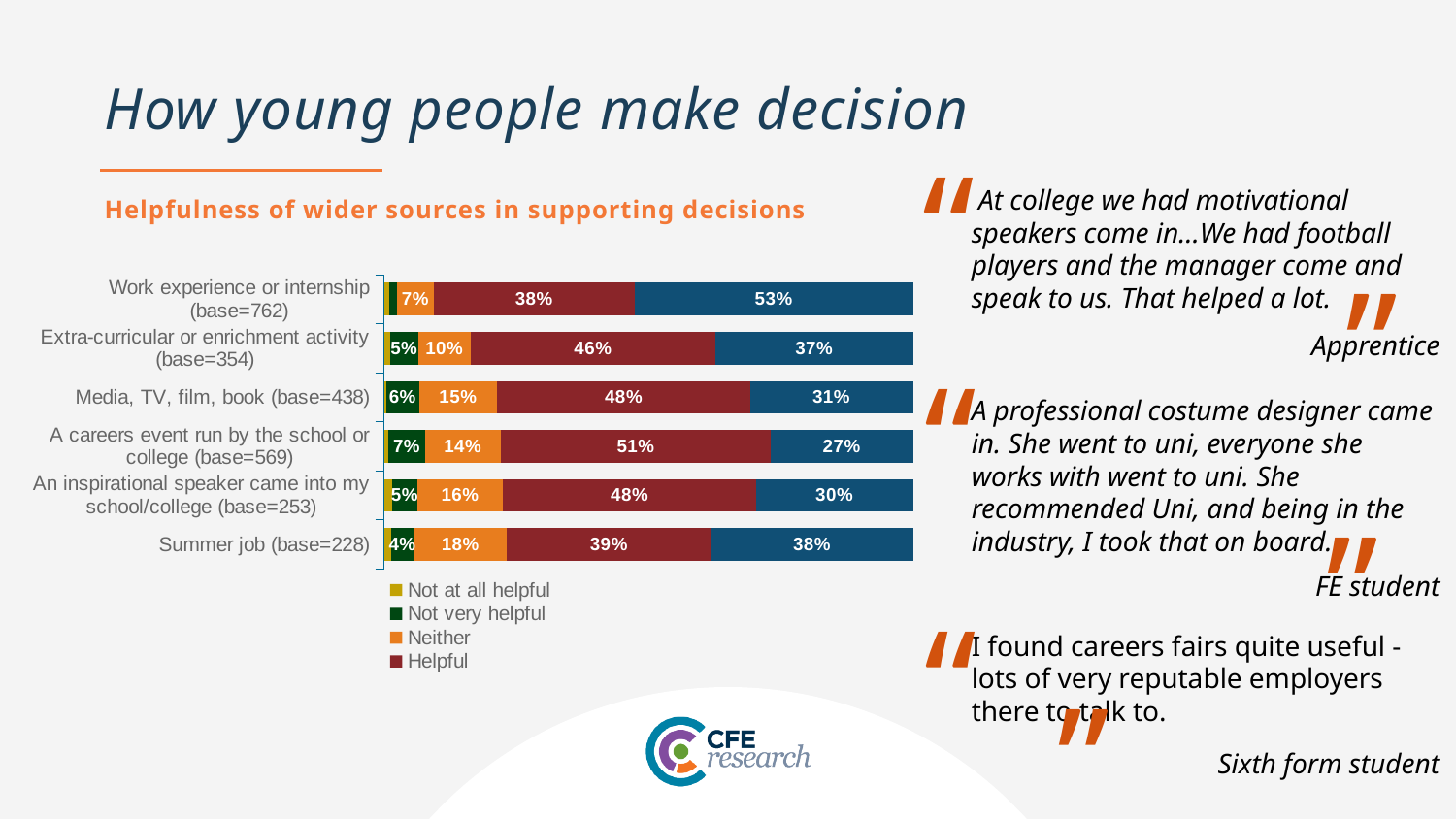
What is the 'Not very helpful' value for 'Media, TV, film, book'? 6% What kind of chart is shown under 'Helpfulness of wider sources in supporting decisions'? Stacked bar chart What percentage rated 'A careers event run by the school or college' as Helpful? 51% Which source has the lowest 'Helpful' percentage? Work experience or internship How many series does the chart's legend list? 4 What is the 'Neither' value for 'Summer job'? 18% Which has a larger 'Neither' value: 'Summer job' or 'Extra-curricular or enrichment activity'? Summer job What is the 'Neither' value for 'Work experience or internship'? 7% What is the difference between the 'Helpful' values for 'Media, TV, film, book' and 'Summer job'? 9 percentage points Which source has the highest 'Helpful' percentage? A careers event run by the school or college What is the title of the chart? Helpfulness of wider sources in supporting decisions How many sources (categories) are plotted in the chart? 6